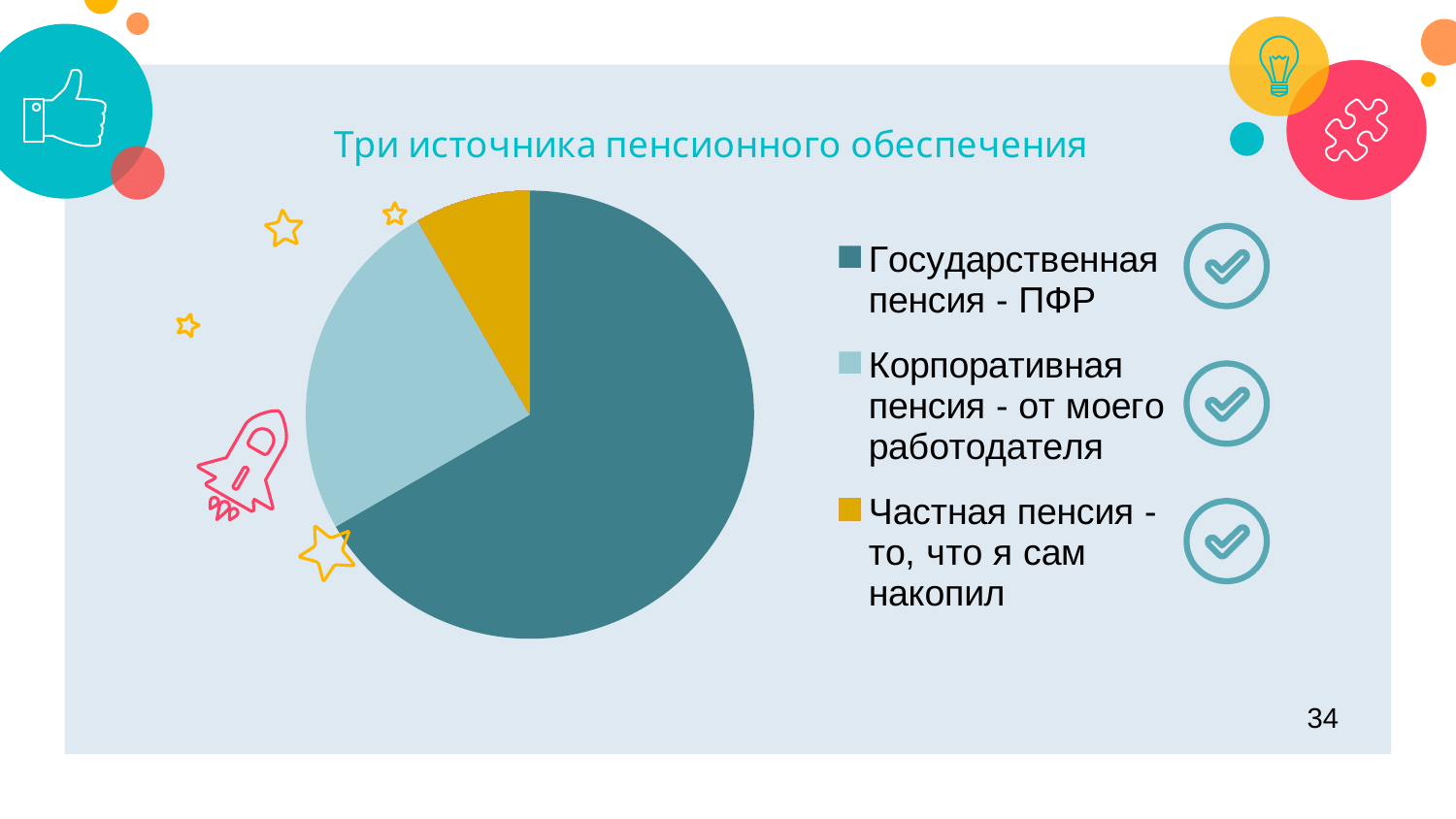
What is the title of the chart on the slide? Три источника пенсионного обеспечения Does the slice for Государственная пенсия - ПФР take up more or less than half of the pie? More Which category has the largest slice of the pie chart? Государственная пенсия - ПФР What kind of chart is shown on the slide? Pie chart What colour is the slice for Частная пенсия - то, что я сам накопил? Yellow Which category has the smallest slice of the pie chart? Частная пенсия - то, что я сам накопил How many slices does the pie chart have? 3 Which slice is larger: Корпоративная пенсия - от моего работодателя or Частная пенсия - то, что я сам накопил? Корпоративная пенсия - от моего работодателя Which slice is larger: Государственная пенсия - ПФР or Корпоративная пенсия - от моего работодателя? Государственная пенсия - ПФР